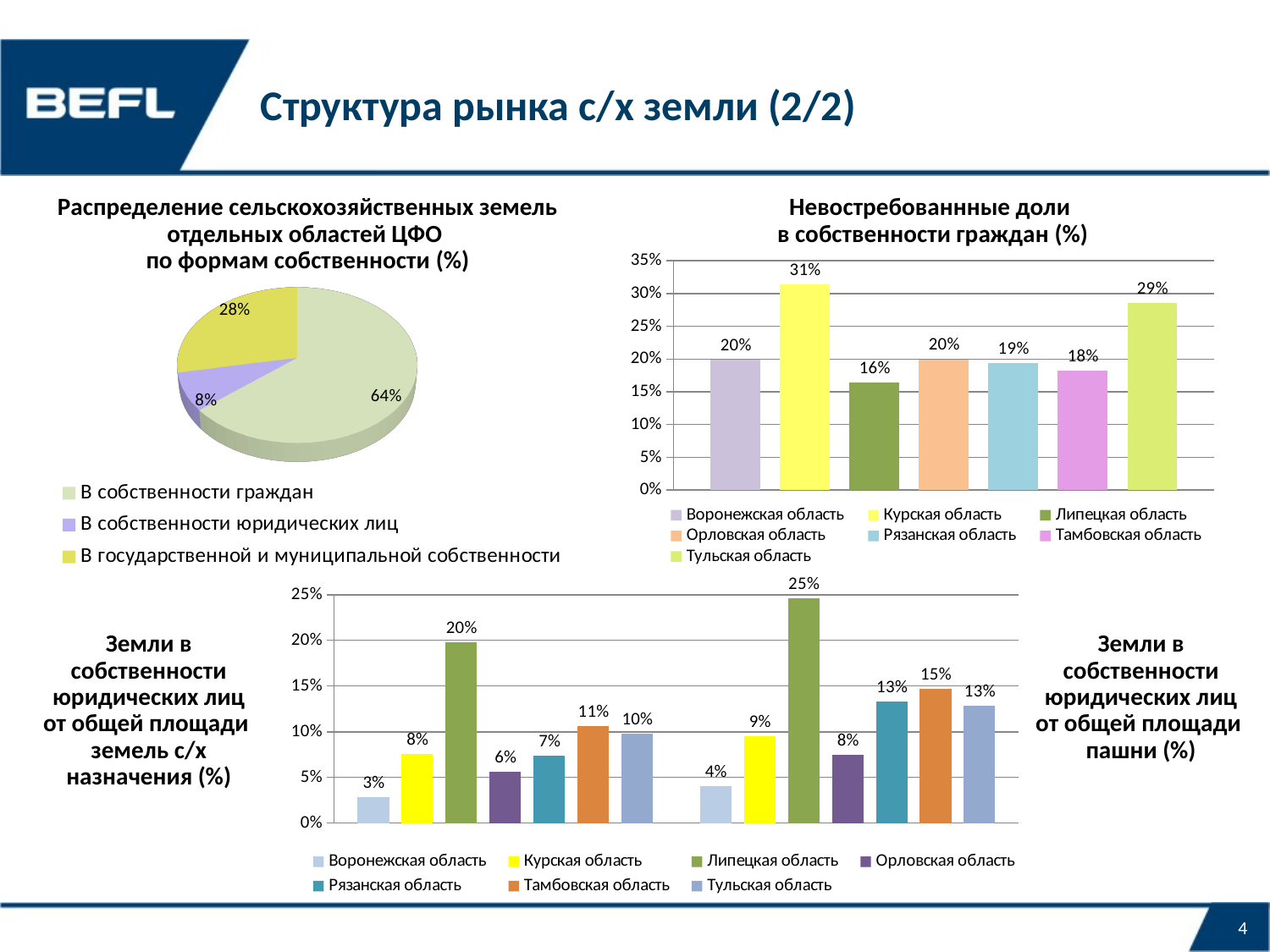
How many series does the legend of the bottom chart list? 7 In the pie chart on the top left, what share is 'В государственной и муниципальной собственности'? 28% In the chart 'Невостребованнные доли в собственности граждан (%)', what is the difference between Курская область and Тульская область? 2% In the bottom chart, which is larger for Тамбовская область: the share of agricultural land (с/х назначения) or the share of arable land (пашни)? Share of arable land (пашни), 15% How many regions are shown in the chart 'Невостребованнные доли в собственности граждан (%)'? 7 In the pie chart on the top left, which category has the smallest share? В собственности юридических лиц What type of chart is the top-left chart? Pie chart In the chart 'Невостребованнные доли в собственности граждан (%)', what is the value for Курская область? 31% In the bottom chart, what is the value for Воронежская область in the group 'Земли в собственности юридических лиц от общей площади земель с/х назначения (%)'? 3% In the pie chart 'Распределение сельскохозяйственных земель отдельных областей ЦФО по формам собственности (%)', what share is 'В собственности граждан'? 64% In the bottom chart, what is the value for Липецкая область in the group 'Земли в собственности юридических лиц от общей площади пашни (%)'? 25% In the chart 'Невостребованнные доли в собственности граждан (%)', which region has the lowest value? Липецкая область